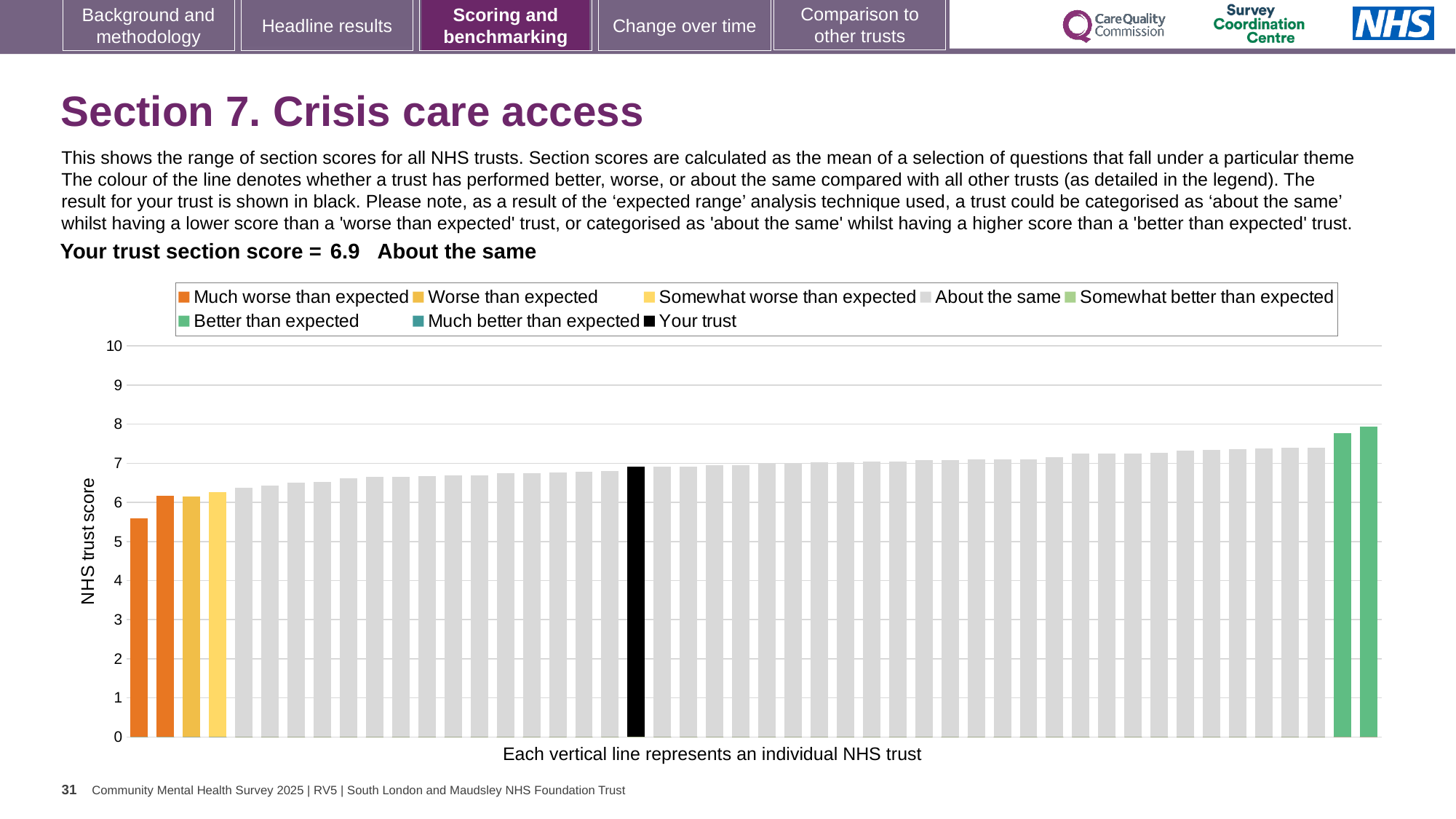
Do the bar values rise or fall from left to right along the x axis? rise Is the value of the rightmost bar greater or less than 7? greater How many bars are coloured as 'Much worse than expected'? 2 Is the value of the black 'Your trust' bar greater or less than 5? greater Is the value of the leftmost bar greater or less than 6? less What is the section score for your trust shown on the slide? 6.9 What is the label on the vertical axis of the chart? NHS trust score Which category is your trust placed in for this section? About the same How many entries does the chart legend list? 8 What type of chart is shown on the slide? bar chart Which is larger, the leftmost bar or the rightmost bar? the rightmost bar